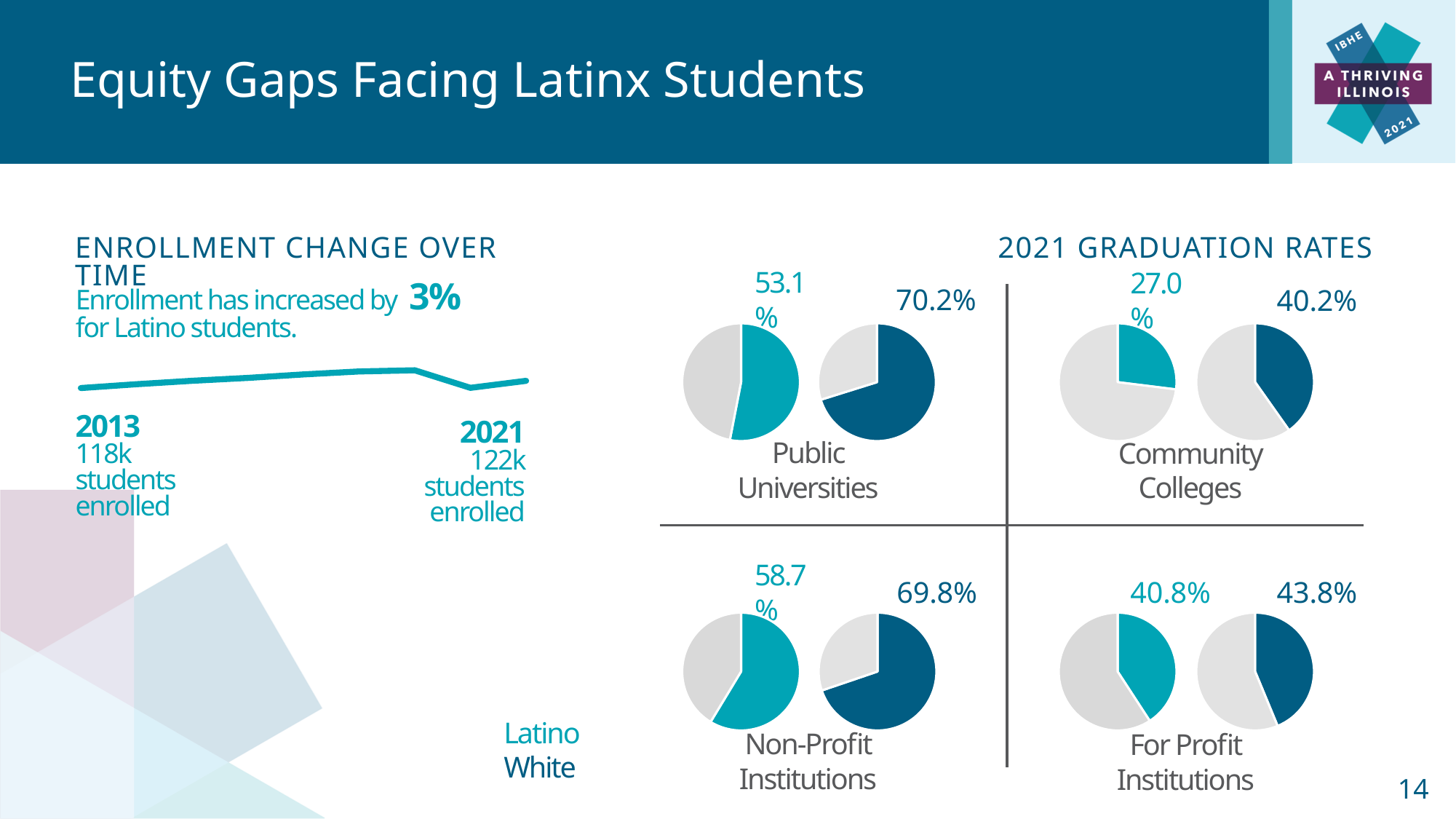
In the 2021 Graduation Rates charts, what is the difference between the White and Latino graduation rates at Public Universities? 17.1 percentage points In the Enrollment Change Over Time chart, how many Latino students were enrolled in 2021? 122k In the 2021 Graduation Rates charts, what is the White graduation rate at Community Colleges? 40.2% In the 2021 Graduation Rates charts, what is the difference between the White and Latino graduation rates at For Profit Institutions? 3.0 percentage points In the 2021 Graduation Rates charts, what is the Latino graduation rate at Public Universities? 53.1% In the 2021 Graduation Rates charts, what is the White graduation rate at For Profit Institutions? 43.8% In the 2021 Graduation Rates charts, what is the Latino graduation rate at Non-Profit Institutions? 58.7% In the Enrollment Change Over Time chart, how many Latino students were enrolled in 2013? 118k In the 2021 Graduation Rates charts, which institution type has the lowest Latino graduation rate? Community Colleges In the 2021 Graduation Rates charts, which institution type has the highest White graduation rate? Public Universities What type of chart is used to show the 2021 Graduation Rates? Pie chart In the 2021 Graduation Rates charts for Community Colleges, which group has the higher graduation rate, Latino or White? White